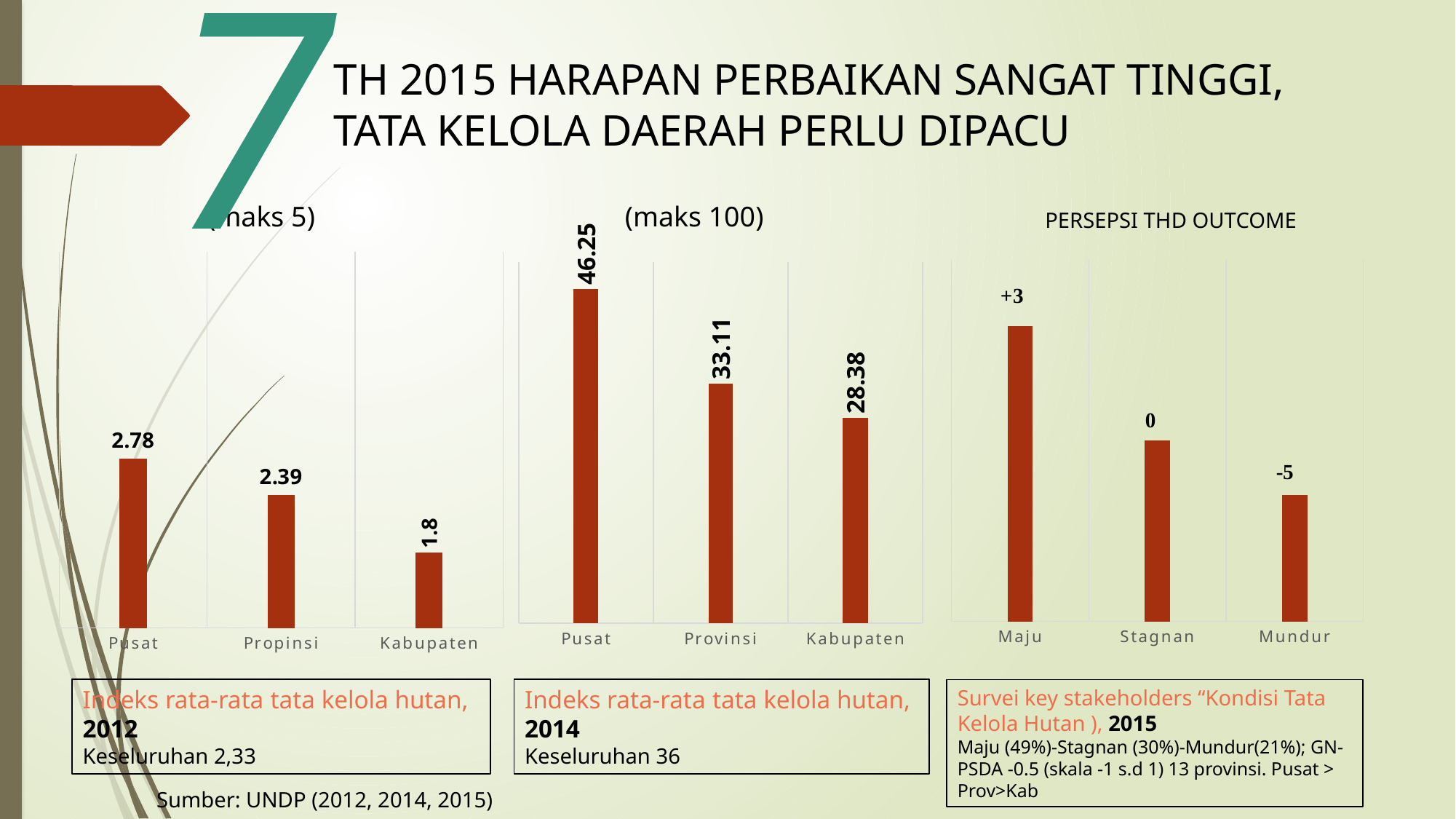
In the middle chart (maks 100), what is the difference between Pusat and Kabupaten? 17.87 In the left chart (maks 5), what is the difference between Pusat and Propinsi? 0.39 In the PERSEPSI THD OUTCOME chart, what is the value labelled for Maju? +3 In the middle chart (maks 100), what is the value for Provinsi? 33.11 How many categories does the PERSEPSI THD OUTCOME chart show? 3 In the PERSEPSI THD OUTCOME chart, what is the value labelled for Mundur? -5 In the left chart (maks 5), what is the value for Kabupaten? 1.8 What type of chart is the middle chart (maks 100)? Bar chart In the middle chart (maks 100), which is larger, Provinsi or Kabupaten? Provinsi In the left chart (maks 5), what is the value for Pusat? 2.78 In the left chart (maks 5), which category has the lowest value? Kabupaten In the middle chart (maks 100), which category has the highest value? Pusat